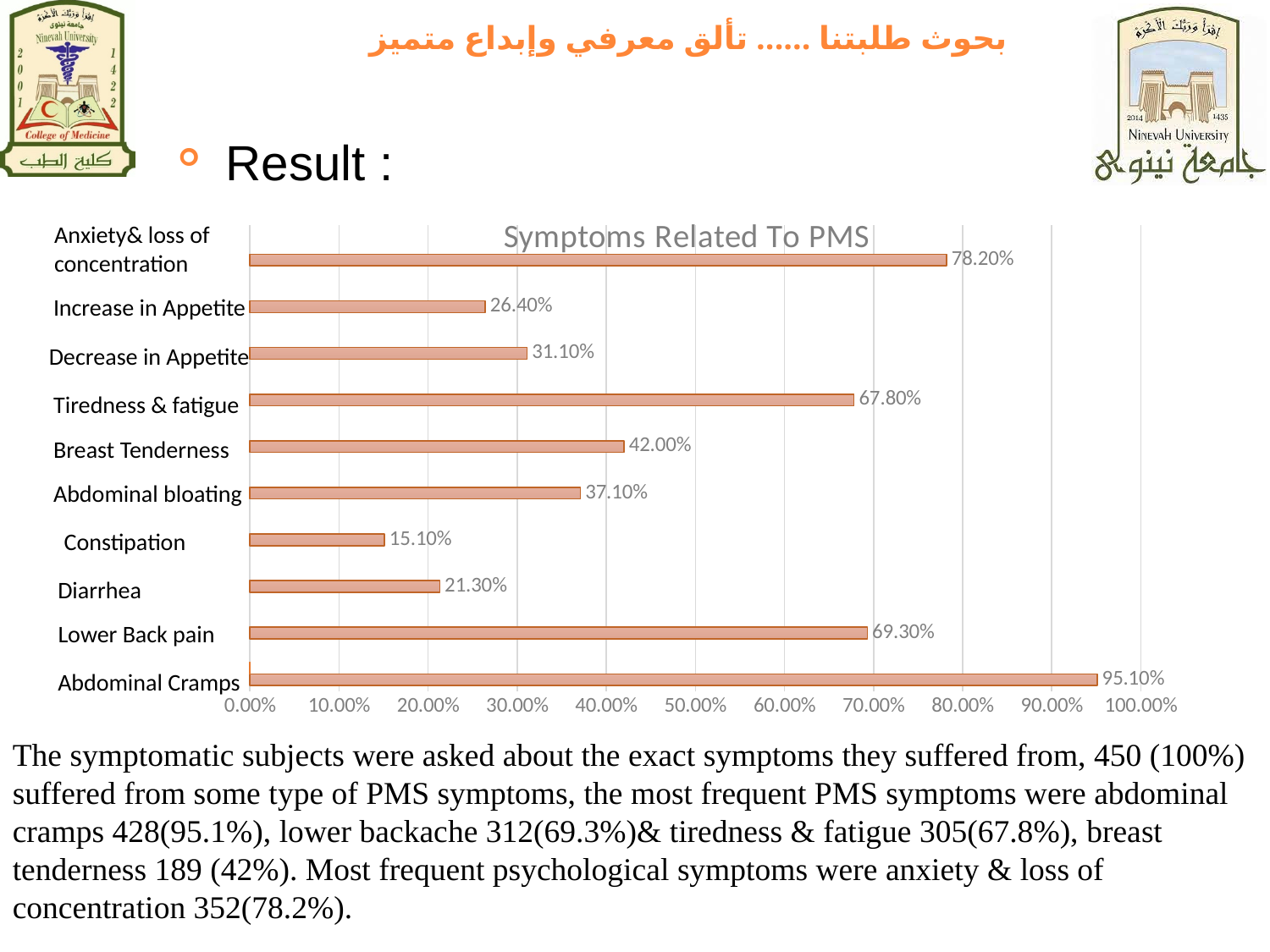
Is the value for Tiredness & fatigue greater or less than 60.00%? greater Which is larger, the value for Breast Tenderness or the value for Abdominal bloating? Breast Tenderness What kind of chart is shown on the slide? bar chart What is the value for Anxiety& loss of concentration? 78.20% How many symptoms are shown in the chart? 10 What is the title of the chart? Symptoms Related To PMS What is the difference between the values for Abdominal Cramps and Lower Back pain? 25.80% What is the difference between the values for Decrease in Appetite and Increase in Appetite? 4.70% Which symptom has the lowest value? Constipation What is the value for Constipation? 15.10% What is the value for Abdominal Cramps in the Symptoms Related To PMS chart? 95.10% Which symptom has the highest value? Abdominal Cramps